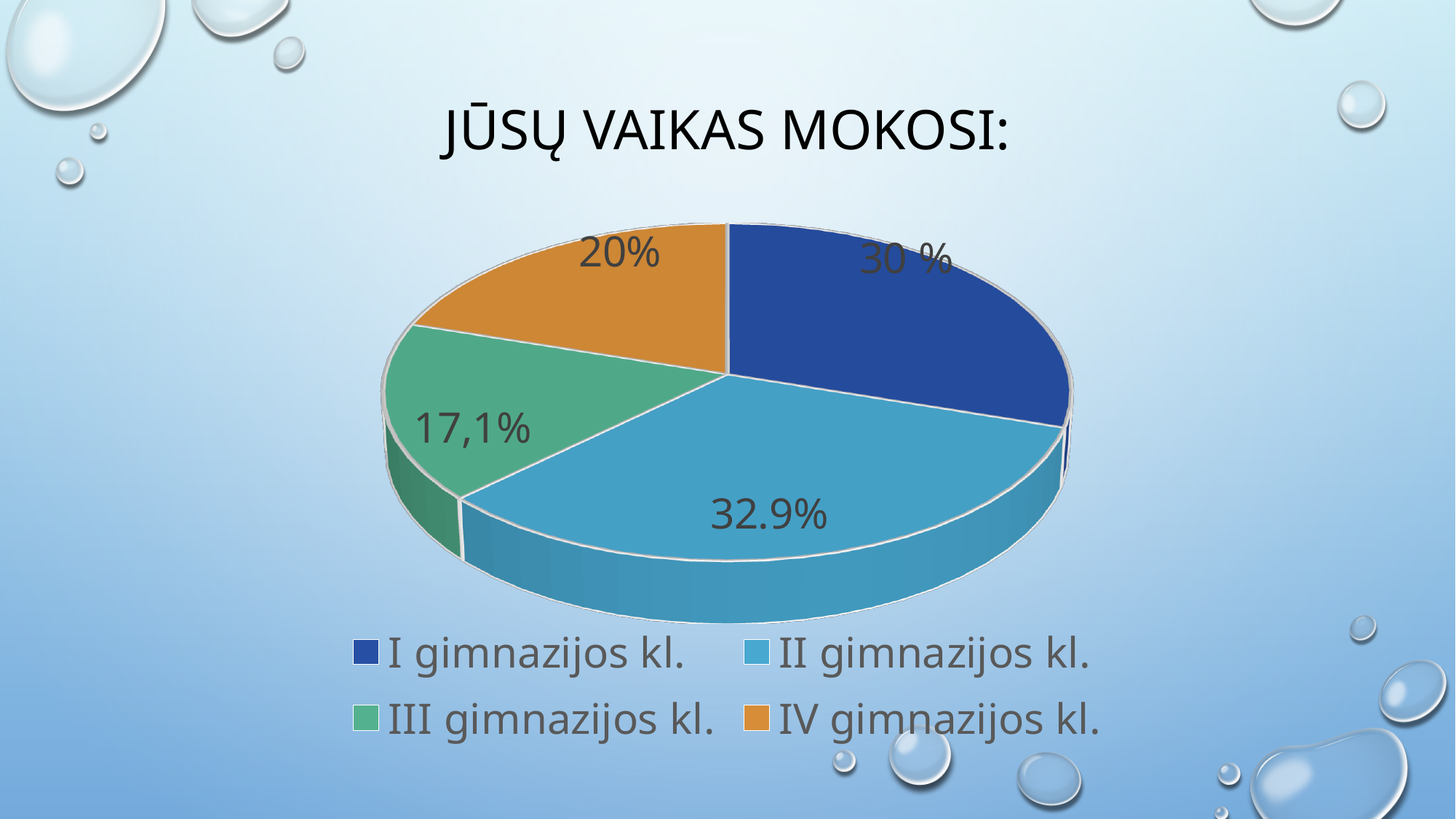
What kind of chart is shown on the slide? pie chart What is the title of the chart? JŪSŲ VAIKAS MOKOSI: What is the difference in percentage points between I gimnazijos kl. and IV gimnazijos kl.? 10 What percentage is shown for II gimnazijos kl.? 32.9% What percentage is shown for IV gimnazijos kl.? 20% Which is larger, the slice for I gimnazijos kl. or the slice for IV gimnazijos kl.? I gimnazijos kl. What percentage is shown for III gimnazijos kl.? 17,1% Which category has the smallest slice of the pie? III gimnazijos kl. Which category has the largest slice of the pie? II gimnazijos kl. What colour is the slice for IV gimnazijos kl.? orange How many categories does the pie chart have? 4 What percentage is shown for I gimnazijos kl.? 30 %